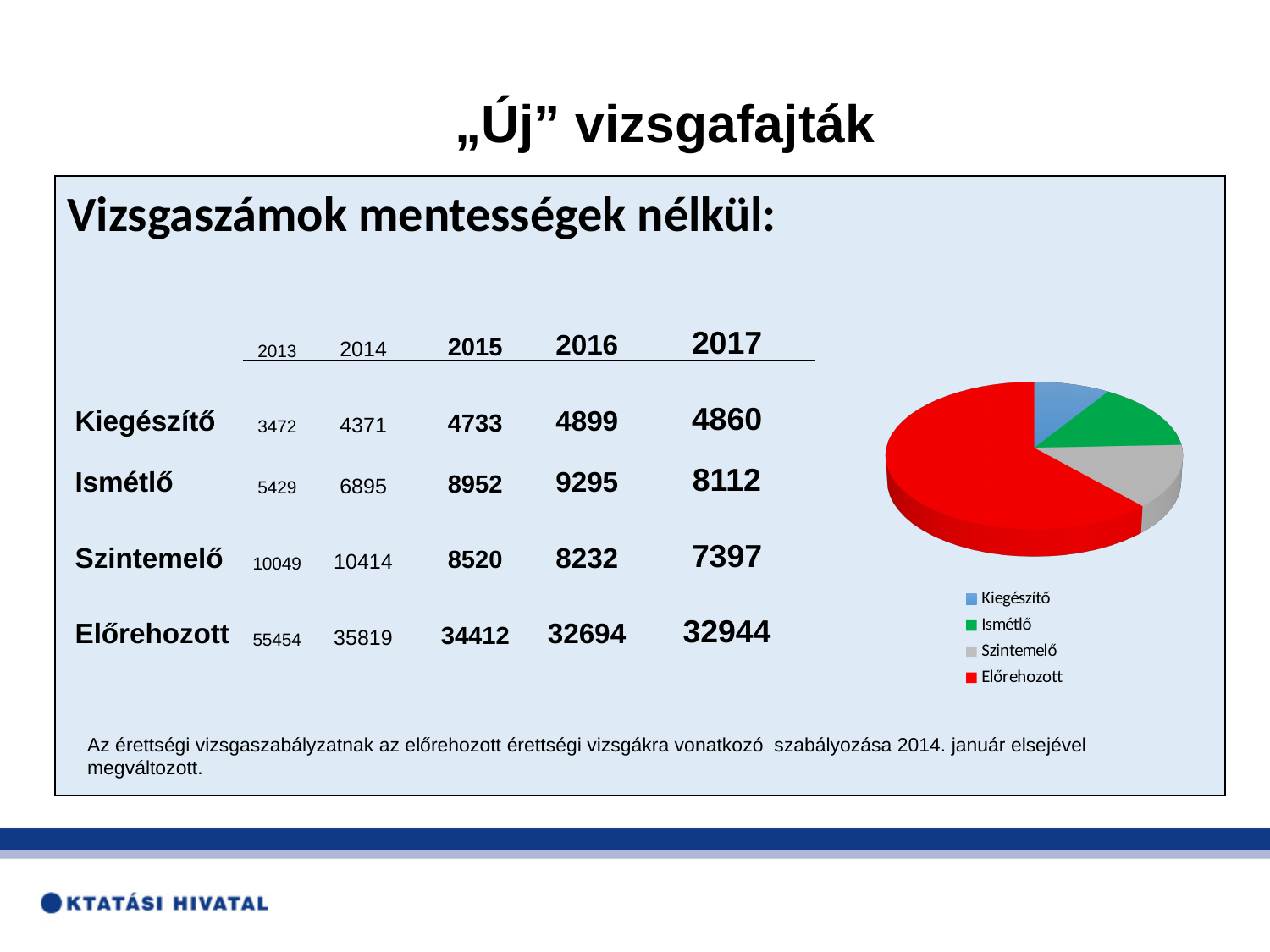
In the pie chart, which slice is larger: Előrehozott or Ismétlő? Előrehozott What kind of chart is shown on the right side of the slide? pie chart In the pie chart, which slice is larger: Szintemelő or Kiegészítő? Szintemelő In the table next to the pie chart, what is the value for Előrehozott in 2017? 32944 Which category is shown in green in the pie chart? Ismétlő How many slices does the pie chart have? 4 In the table next to the pie chart, what is the difference between the Ismétlő values for 2016 and 2017? 1183 Which category has the smallest slice in the pie chart? Kiegészítő How many entries does the pie chart's legend list? 4 In the table next to the pie chart, what is the value for Szintemelő in 2013? 10049 What colour is the Előrehozott slice in the pie chart? red Which category has the largest slice in the pie chart? Előrehozott